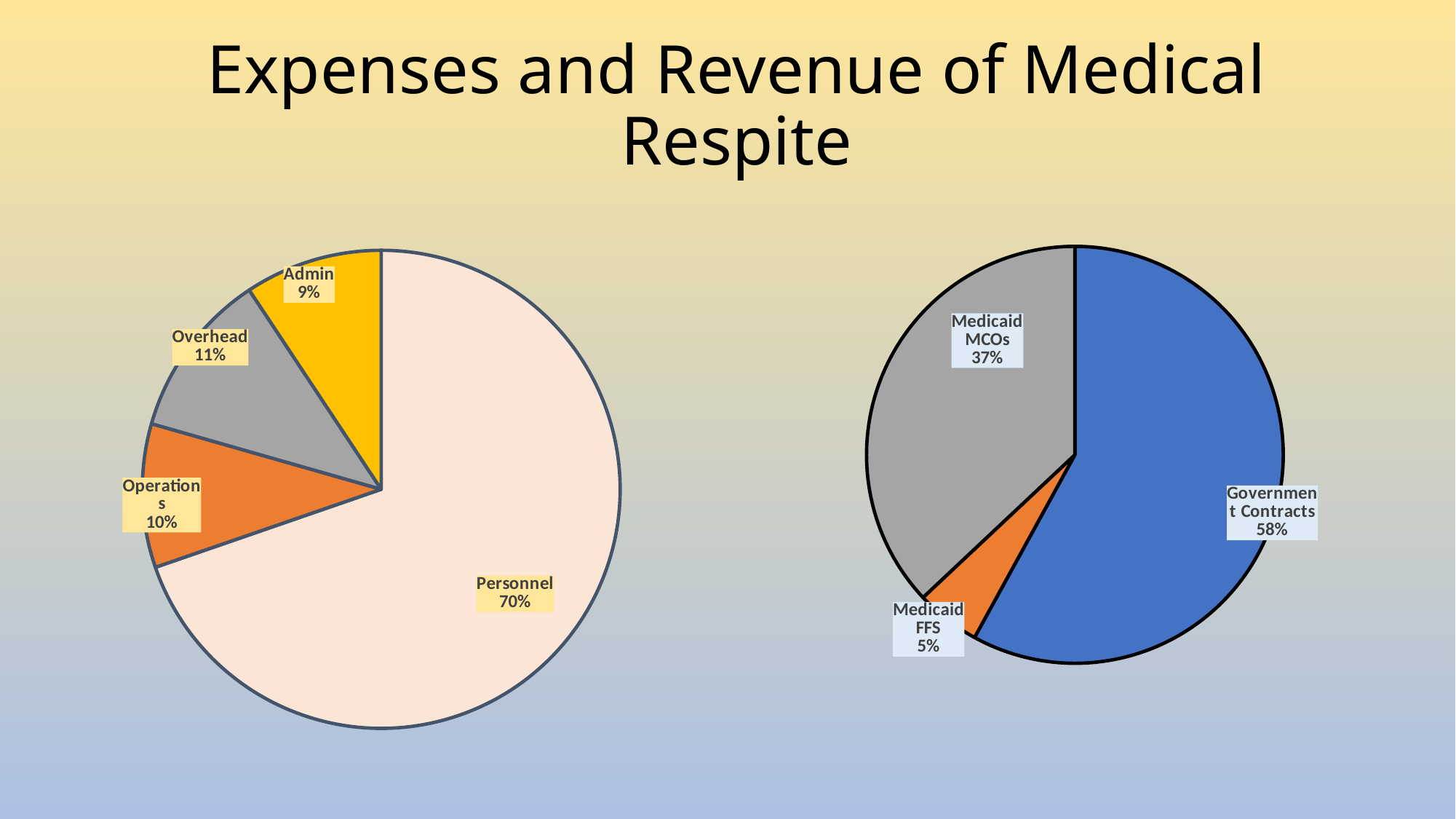
In the left pie chart, what is the difference between the Personnel share and the Operations share? 60% In the right pie chart, what share do Medicaid MCOs have? 37% In the left pie chart, what share does Overhead have? 11% In the left pie chart, which category has the largest share? Personnel In the left pie chart, what share does Personnel have? 70% In the left pie chart, how many slices are there? 4 In the right pie chart, what share does Medicaid FFS have? 5% What type of chart is used on the slide? Pie chart In the right pie chart, how many slices are there? 3 In the left pie chart, which category has the smallest share? Admin In the right pie chart, which category has the largest share? Government Contracts In the right pie chart, what is the difference between the Government Contracts share and the Medicaid MCOs share? 21%